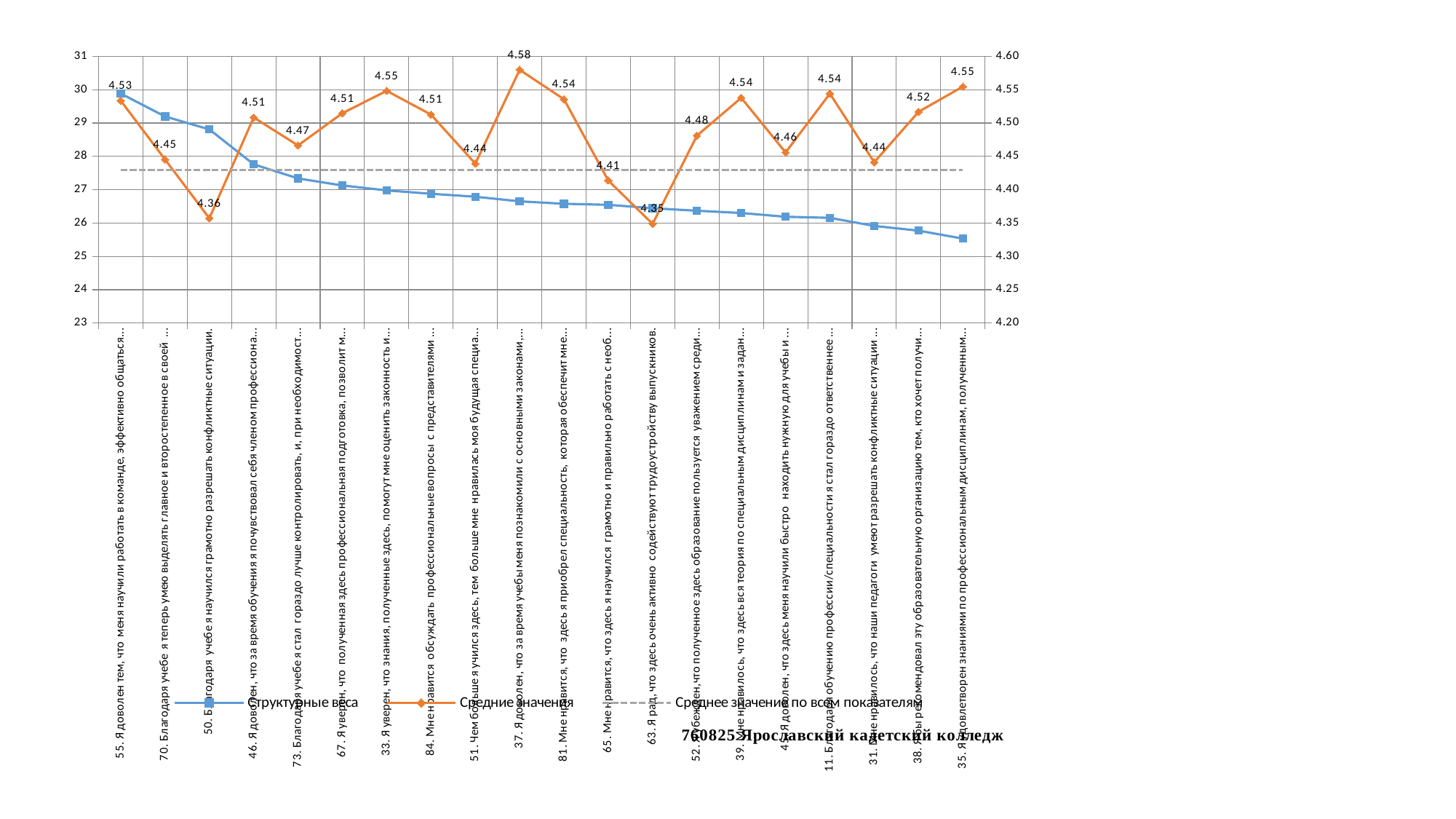
What is the difference between the highest and lowest values of the 'Средние значения' series? 0.23 Which category has the highest value in the 'Средние значения' series? 37. Я доволен, что за время учебы меня познакомили с основными законами,... Which category has the lowest value in the 'Средние значения' series? 63. Я рад, что здесь очень активно содействуют трудоустройству выпускников. Is the value of the 'Структурные веса' series for the first category '55. Я доволен тем, что меня научили работать в команде...' greater or less than 29 on the left axis? greater How many categories are plotted along the x axis? 20 Does the 'Структурные веса' series rise or fall from left to right along the x axis? fall How many series does the legend list? 3 What is the value of the 'Средние значения' series for the category '55. Я доволен тем, что меня научили работать в команде, эффективно общаться...'? 4.53 What kind of chart is shown on the slide? line chart In the 'Средние значения' series, which is larger: the value for '38. Я бы рекомендовал эту образовательную организацию тем, кто хочет получи...' or for '35. Я удовлетворен знаниями по профессиональным дисциплинам, полученным...'? 35. Я удовлетворен знаниями по профессиональным дисциплинам, полученным... What is the name of the dashed series in the legend? Среднее значение по всем показателям What is the value of the 'Средние значения' series for the category '63. Я рад, что здесь очень активно содействуют трудоустройству выпускников.'? 4.35